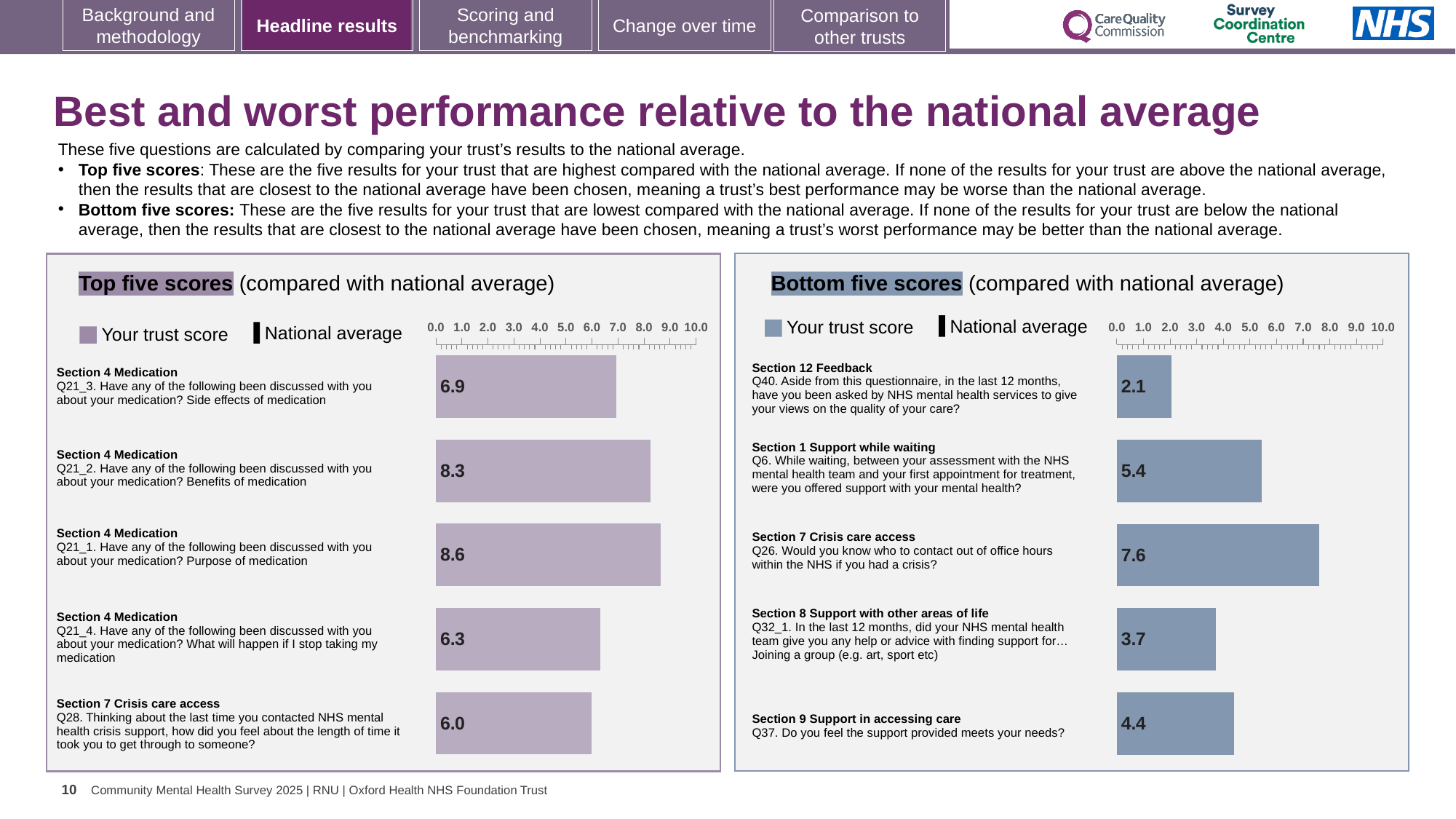
On the 'Top five scores' chart, how many questions are plotted? 5 On the 'Top five scores' chart, what is the difference between the trust scores for Q21_1 (Purpose of medication) and Q21_4 (What will happen if I stop taking my medication)? 2.3 On the 'Top five scores' chart, what is the trust score for Q28 about the length of time it took to get through to someone? 6.0 On the 'Top five scores' chart, which question has the highest trust score? Q21_1. Purpose of medication On the 'Bottom five scores' chart, what is the trust score for Q37 (Do you feel the support provided meets your needs)? 4.4 On the 'Bottom five scores' chart, what is the trust score for Q40 about being asked for views on the quality of care? 2.1 On the 'Bottom five scores' chart, what is the difference between the trust scores for Q26 (crisis contact out of office hours) and Q40 (asked for views on quality of care)? 5.5 On the 'Top five scores' chart, what is the trust score for Q21_3 (Side effects of medication)? 6.9 On the 'Bottom five scores' chart, which question has the lowest trust score? Q40 (Section 12 Feedback) On the 'Bottom five scores' chart, which has the larger trust score: Q6 (support while waiting) or Q32_1 (joining a group)? Q6 (support while waiting) What type of chart is used in the 'Top five scores' panel? Bar chart How many series does the legend of the 'Bottom five scores' chart list? 2